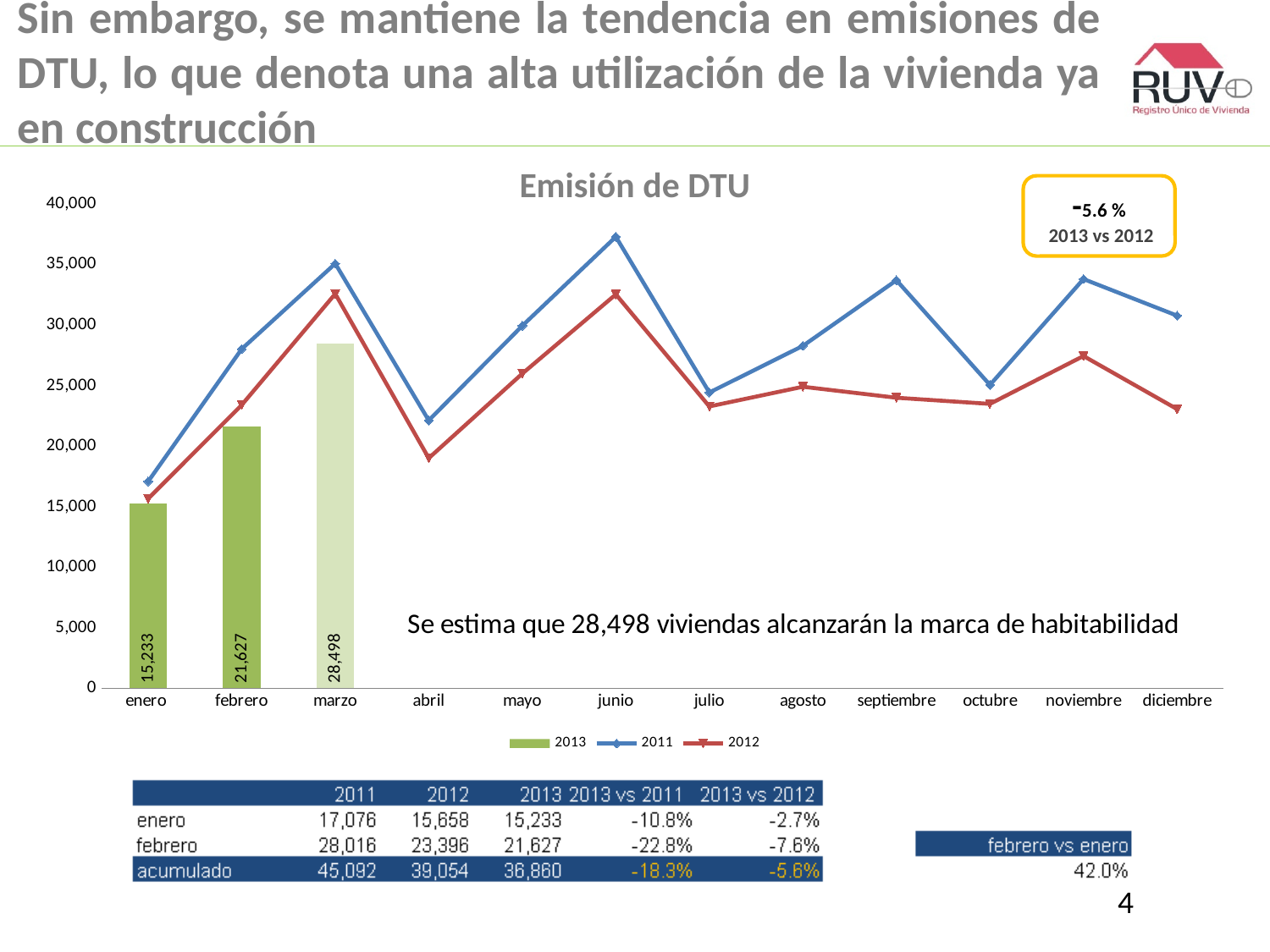
What is the value of the 2013 bar for marzo? 28,498 Is the 2011 value for junio greater or less than 35,000? greater What is the value of the 2013 bar for febrero? 21,627 Which month has the highest 2013 bar? marzo What kind of chart is shown? Combined bar and line chart What is the difference between the 2013 values for febrero and enero? 6,394 Is the 2012 value for abril greater or less than 20,000? less How many months are shown on the x axis? 12 How many series does the legend list? 3 Which month has the lowest 2013 bar? enero What is the value of the 2013 bar for enero in the Emisión de DTU chart? 15,233 In septiembre, which series has the higher value, 2011 or 2012? 2011